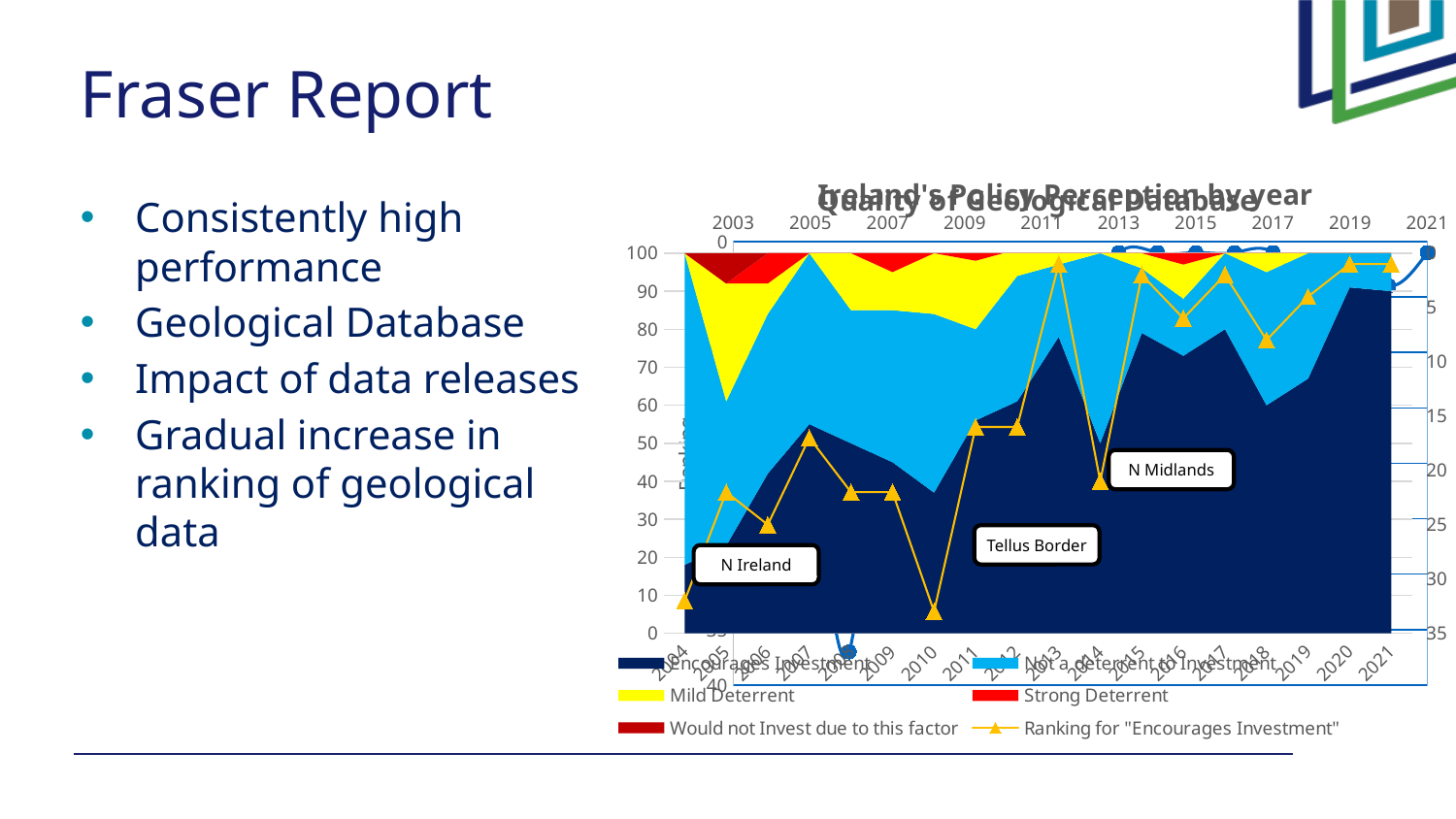
What is the title of the chart in the background whose x axis runs from 2003 to 2021? Ireland's Policy Perception by year In the Quality of Geological Database chart, how many entries does the legend list? 6 In the Quality of Geological Database chart, what is the first year shown on the x axis? 2004 What is the title of the chart in the foreground on the slide? Quality of Geological Database What kind of chart is the Quality of Geological Database chart? stacked area chart with a line In the Quality of Geological Database chart, which legend entry is shown in yellow? Mild Deterrent In the Quality of Geological Database chart, does the Encourages Investment area generally rise or fall from 2004 to 2021? rise In the Quality of Geological Database chart, what is the last year shown on the x axis? 2021 In the Quality of Geological Database chart, how many years are shown along the x axis? 18